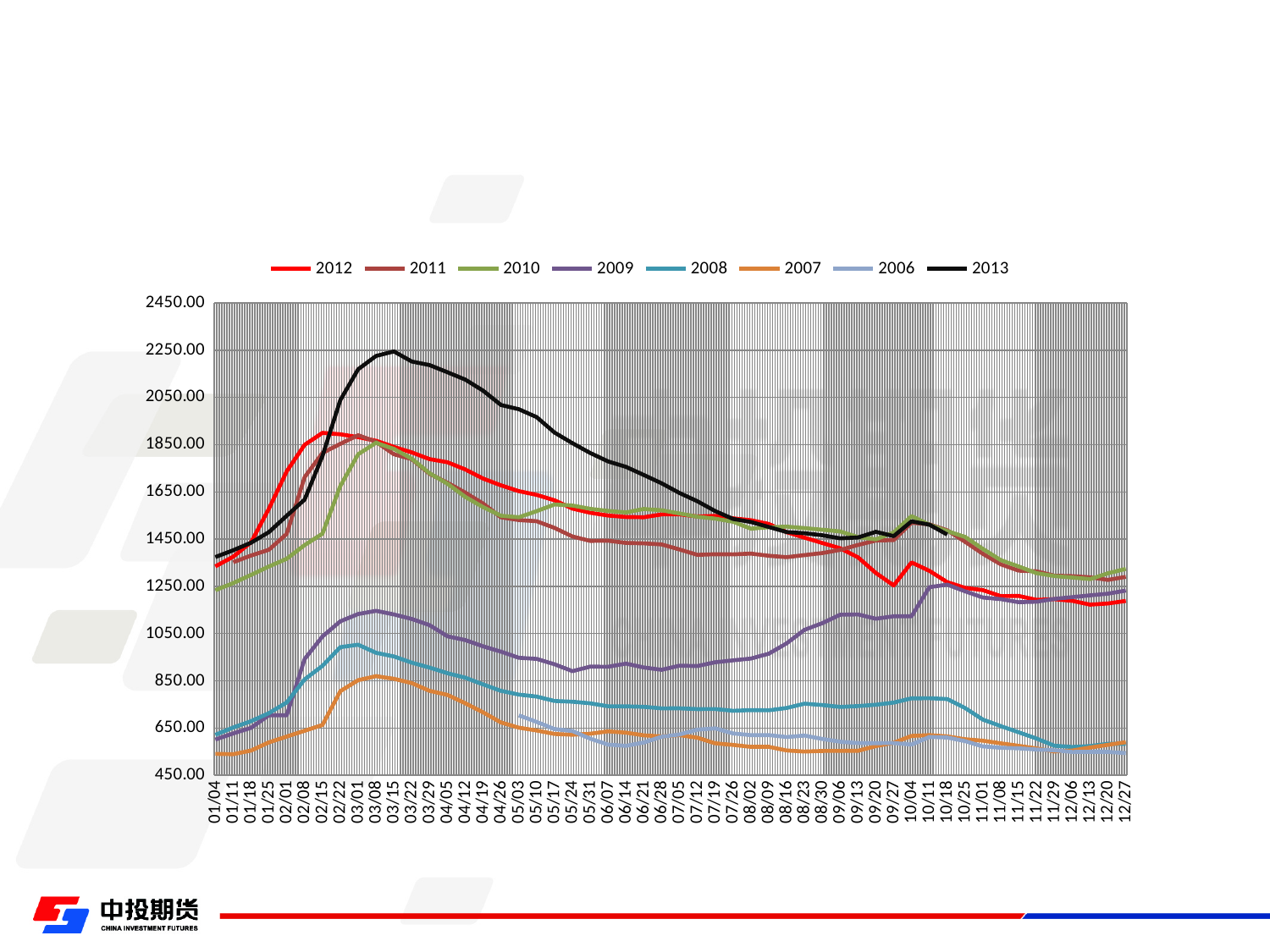
Does the 2012 series rise or fall between 01/04 and 02/22? rise What kind of chart is shown on the slide? line chart Does the 2013 series rise or fall between 03/15 and 10/18? fall Is the value of the 2007 series at 03/08 greater or less than 1050? less What is the highest value shown on the y axis? 2450.00 Which series has the lowest value at 01/04? 2007 How many series does the legend list? 8 At 12/27, which series has the higher value, 2010 or 2012? 2010 Is the value of the 2013 series at 03/15 greater or less than 2050? greater At 03/15, which series has the higher value, 2013 or 2012? 2013 Is the value of the 2009 series at 03/08 greater or less than 1250? less Which series reaches the highest peak on the chart? 2013